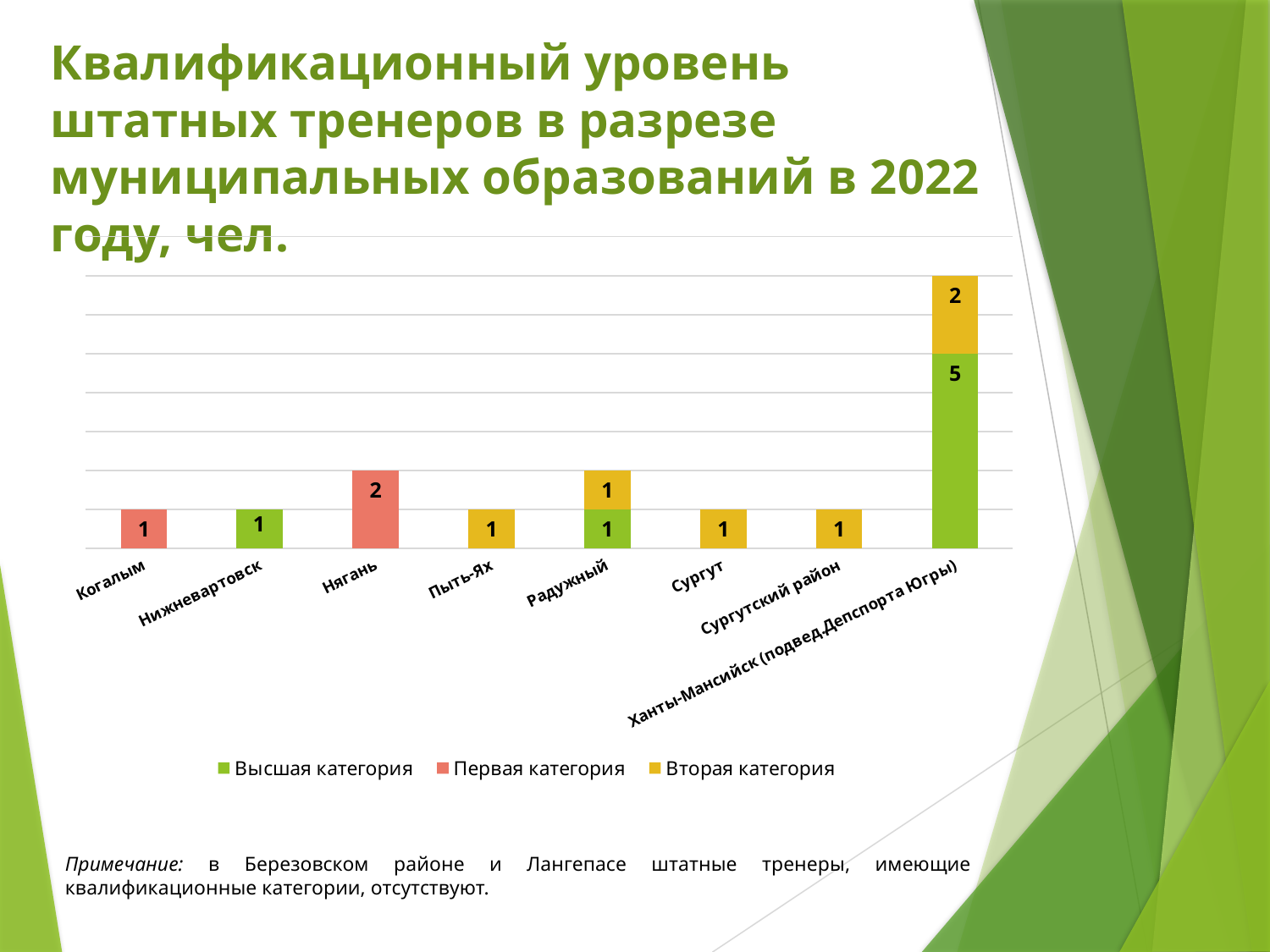
What is the total of the stacked bar for Ханты-Мансийск (подвед.Депспорта Югры)? 7 Which series is shown in green in the legend? Высшая категория What is the value of Вторая категория for Радужный? 1 What is the value of Высшая категория for Ханты-Мансийск (подвед.Депспорта Югры)? 5 What is the total of the stacked bar for Радужный? 2 What is the value of Вторая категория for Ханты-Мансийск (подвед.Депспорта Югры)? 2 How many municipalities (categories) are shown on the x axis? 8 What kind of chart is shown on the slide? stacked bar chart What is the difference between the Высшая категория value for Ханты-Мансийск (подвед.Депспорта Югры) and the Первая категория value for Нягань? 3 Which municipality has the highest total number of coaches? Ханты-Мансийск (подвед.Депспорта Югры) How many series does the legend list? 3 What is the value of Первая категория for Нягань? 2